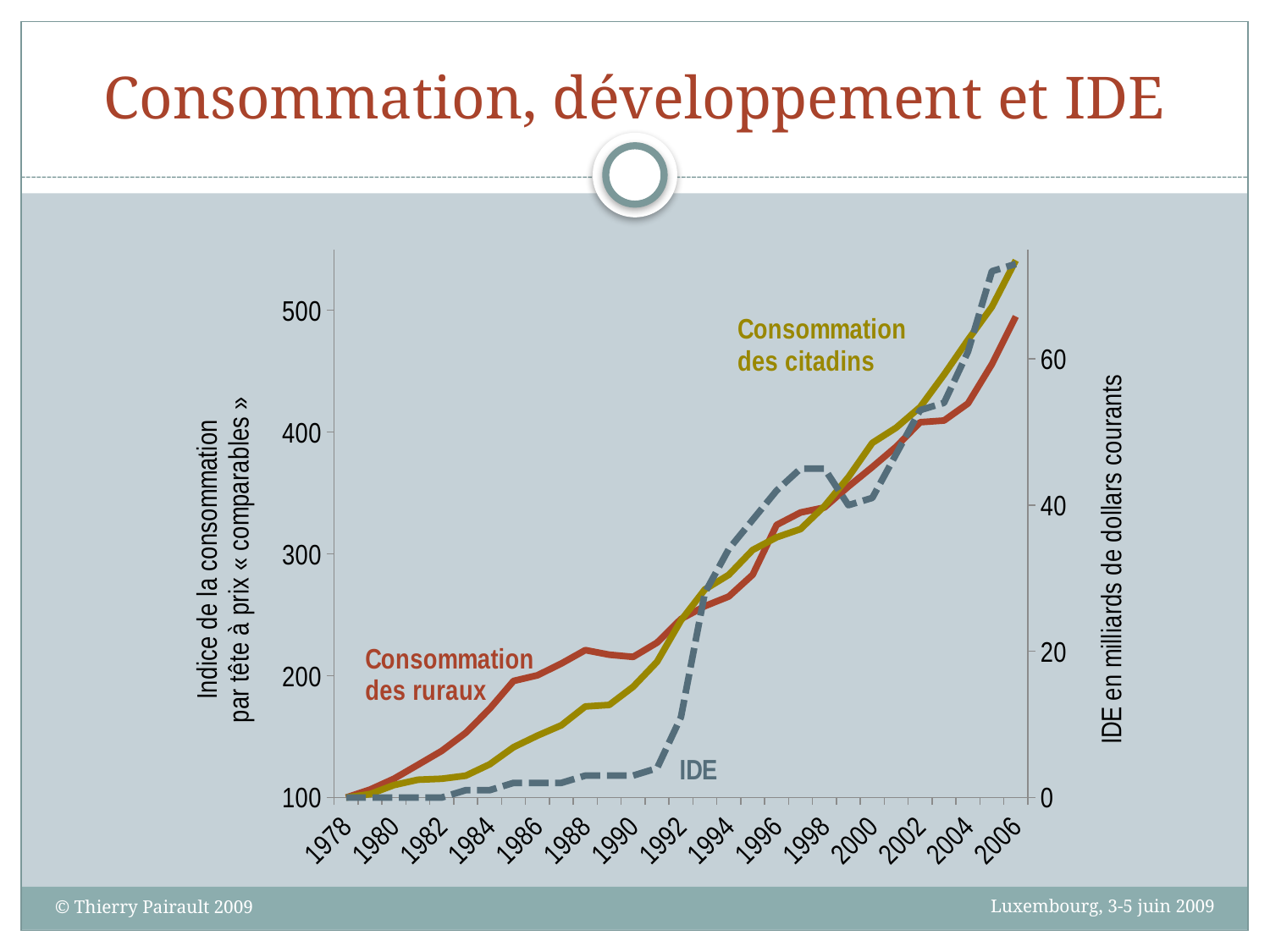
Is the value for 'Consommation des ruraux' in 1988 greater or less than 200? greater Is the value for IDE in 1998 greater or less than 40 billion dollars? greater In 2006, which is higher: 'Consommation des ruraux' or 'Consommation des citadins'? Consommation des citadins Is the value for 'Consommation des citadins' in 1988 greater or less than 200? less What kind of chart is shown on the slide? line chart How many data series are plotted on the chart? 3 What is the value of the consumption index for both 'Consommation des ruraux' and 'Consommation des citadins' in 1978? 100 How many year labels are shown on the x axis? 15 What is the title of the right-hand vertical axis? IDE en milliards de dollars courants In 1988, which is higher: 'Consommation des ruraux' or 'Consommation des citadins'? Consommation des ruraux Does 'Consommation des citadins' rise or fall between 1978 and 2006? rise